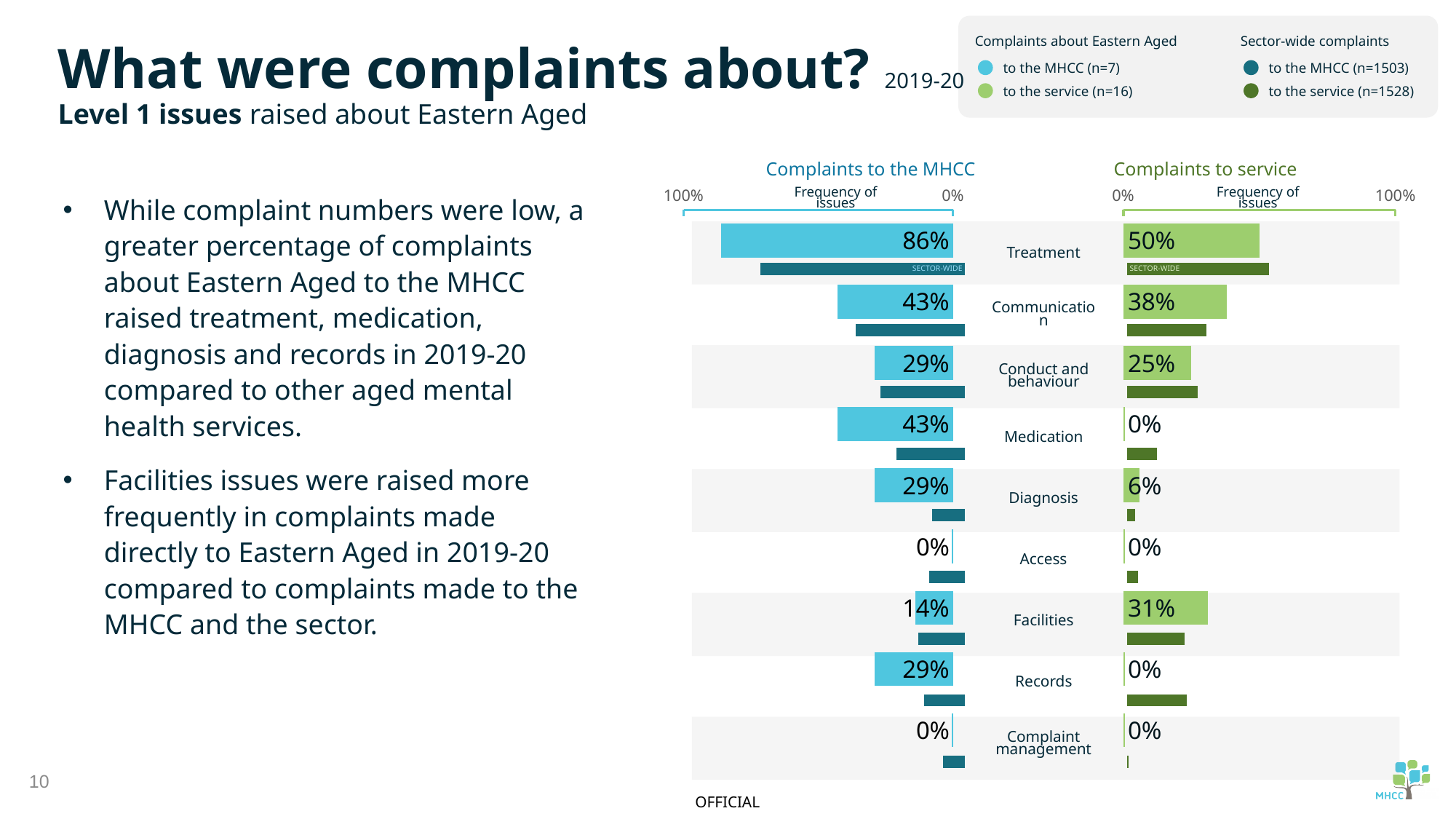
In the 'Complaints to the MHCC' chart, what percentage of complaints raised Medication? 43% Is the Facilities percentage larger in the 'Complaints to the MHCC' chart or the 'Complaints to service' chart? Complaints to service How many series does the legend at the top right of the slide list? 4 In the 'Complaints to service' chart, which issue has the highest frequency? Treatment In the 'Complaints to service' chart, what percentage of complaints raised Diagnosis? 6% In the 'Complaints to the MHCC' chart, which issue has the highest frequency for Eastern Aged? Treatment What type of chart is used to show the frequency of issues in 'Complaints to the MHCC'? Bar chart What is the difference between the Treatment percentage in the 'Complaints to the MHCC' chart and the Treatment percentage in the 'Complaints to service' chart? 36% How many issue categories are listed in the 'Complaints to the MHCC' chart? 9 In the 'Complaints to the MHCC' chart, what percentage of Eastern Aged complaints raised Treatment? 86% In the 'Complaints to service' chart, what percentage of complaints raised Facilities? 31% In the 'Complaints to the MHCC' chart, what is the difference between the Communication and Facilities percentages? 29%